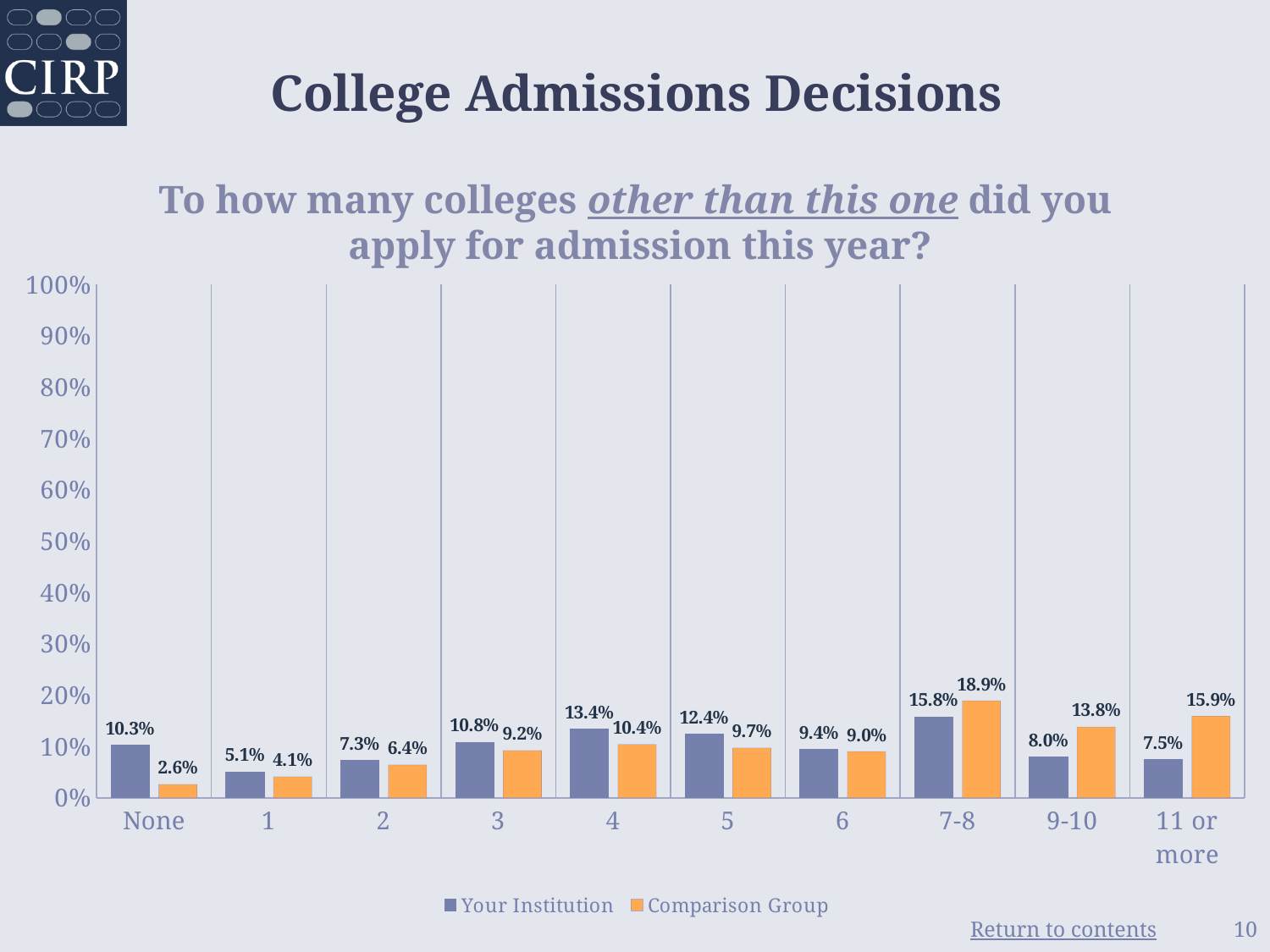
Which category has the highest value for the Comparison Group? 7-8 What is the value for the Comparison Group in the "11 or more" category? 15.9% What is the difference between Your Institution and the Comparison Group in the "None" category? 7.7 percentage points In the "9-10" category, which series has the larger value, Your Institution or the Comparison Group? Comparison Group What kind of chart is shown on the slide? Bar chart What is the difference between the Comparison Group and Your Institution in the "11 or more" category? 8.4 percentage points Which category has the lowest value for the Comparison Group? None What is the value for Your Institution in the "None" category? 10.3% What is the value for Your Institution in the "4" category? 13.4% How many series does the legend list? 2 Which category has the lowest value for Your Institution? 1 How many categories are shown on the x axis? 10